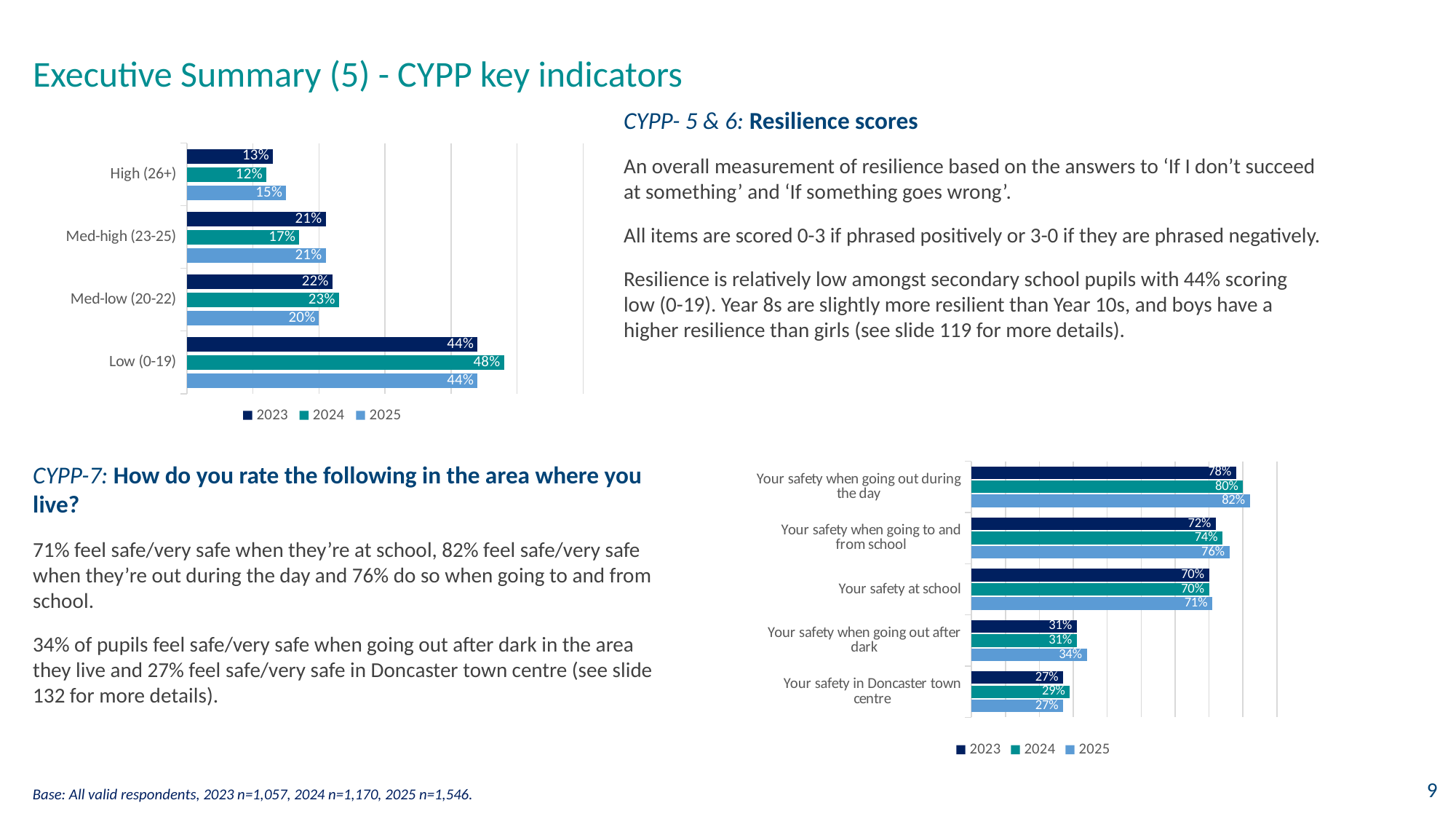
What kind of chart is the safety chart at the bottom right of the slide? bar chart In the resilience scores chart (top left), how many series does the legend list? 3 In the safety chart (bottom right), what is the 2023 value for 'Your safety in Doncaster town centre'? 27% In the resilience scores chart (top left), which category has the highest value for 2023? Low (0-19) In the safety chart (bottom right), what is the 2025 value for 'Your safety when going out during the day'? 82% In the safety chart (bottom right), how many categories are shown? 5 In the resilience scores chart (top left), what is the value for Low (0-19) in 2024? 48% In the resilience scores chart (top left), what is the value for High (26+) in 2025? 15% In the resilience scores chart (top left), what is the difference between the 2024 and 2023 values for Low (0-19)? 4% In the safety chart (bottom right), is the 2025 value for 'Your safety when going to and from school' larger or smaller than the 2025 value for 'Your safety at school'? larger In the safety chart (bottom right), which category has the lowest 2025 value? Your safety in Doncaster town centre In the resilience scores chart (top left), which category has the lowest value for 2024? High (26+)